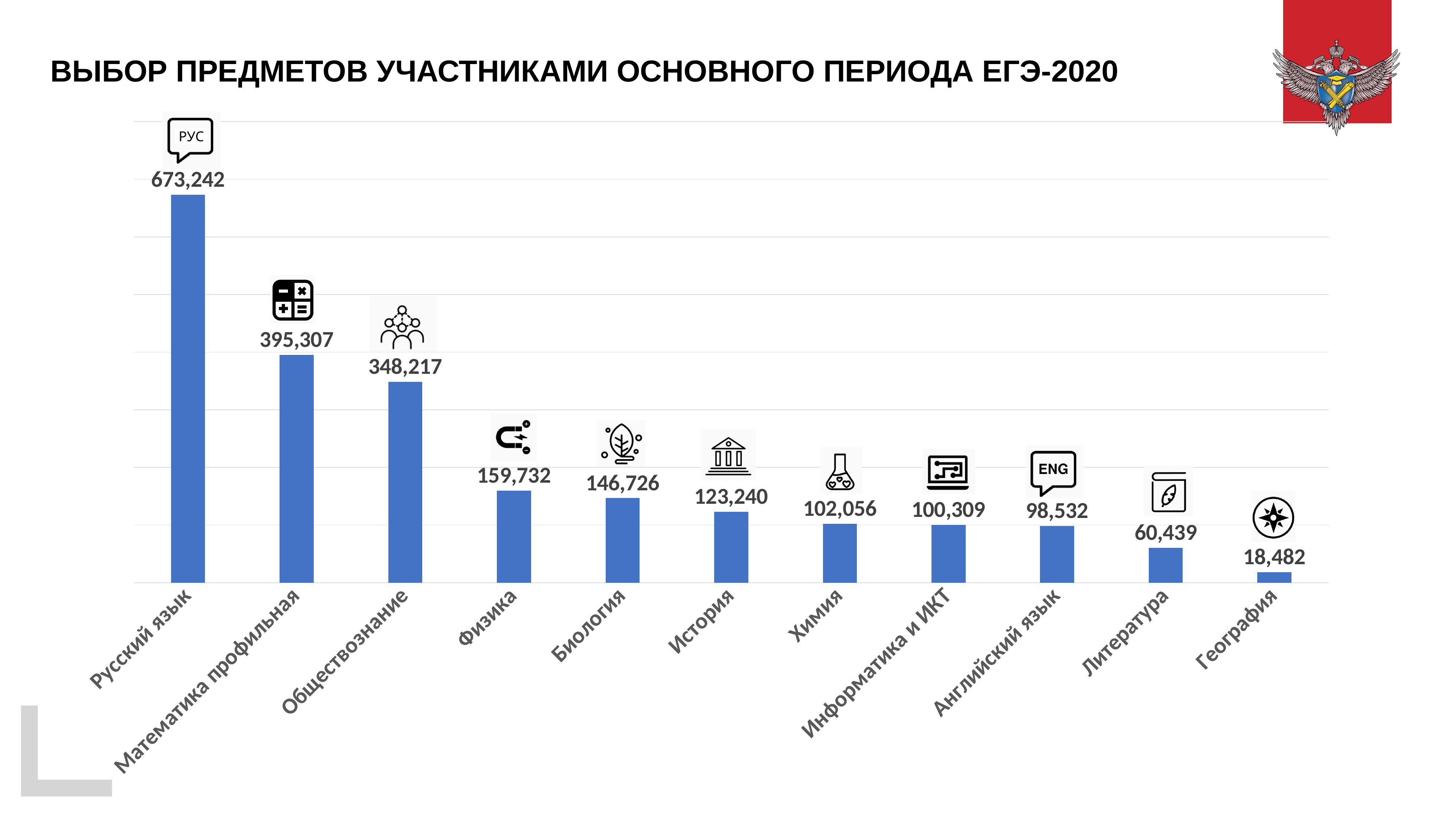
Which subject has the lowest value? География What kind of chart is shown on the slide? Bar chart What is the value for Литература? 60,439 How many subjects are shown in the chart? 11 Do the values rise or fall from left to right along the x axis? Fall What is the difference between the values for Литература and География? 41,957 What is the difference between the values for Русский язык and Математика профильная? 277,935 Which subject has the highest value? Русский язык What is the value for Русский язык? 673,242 Which is larger, the value for Физика or the value for История? Физика What is the value for Информатика и ИКТ? 100,309 What is the value for Обществознание? 348,217